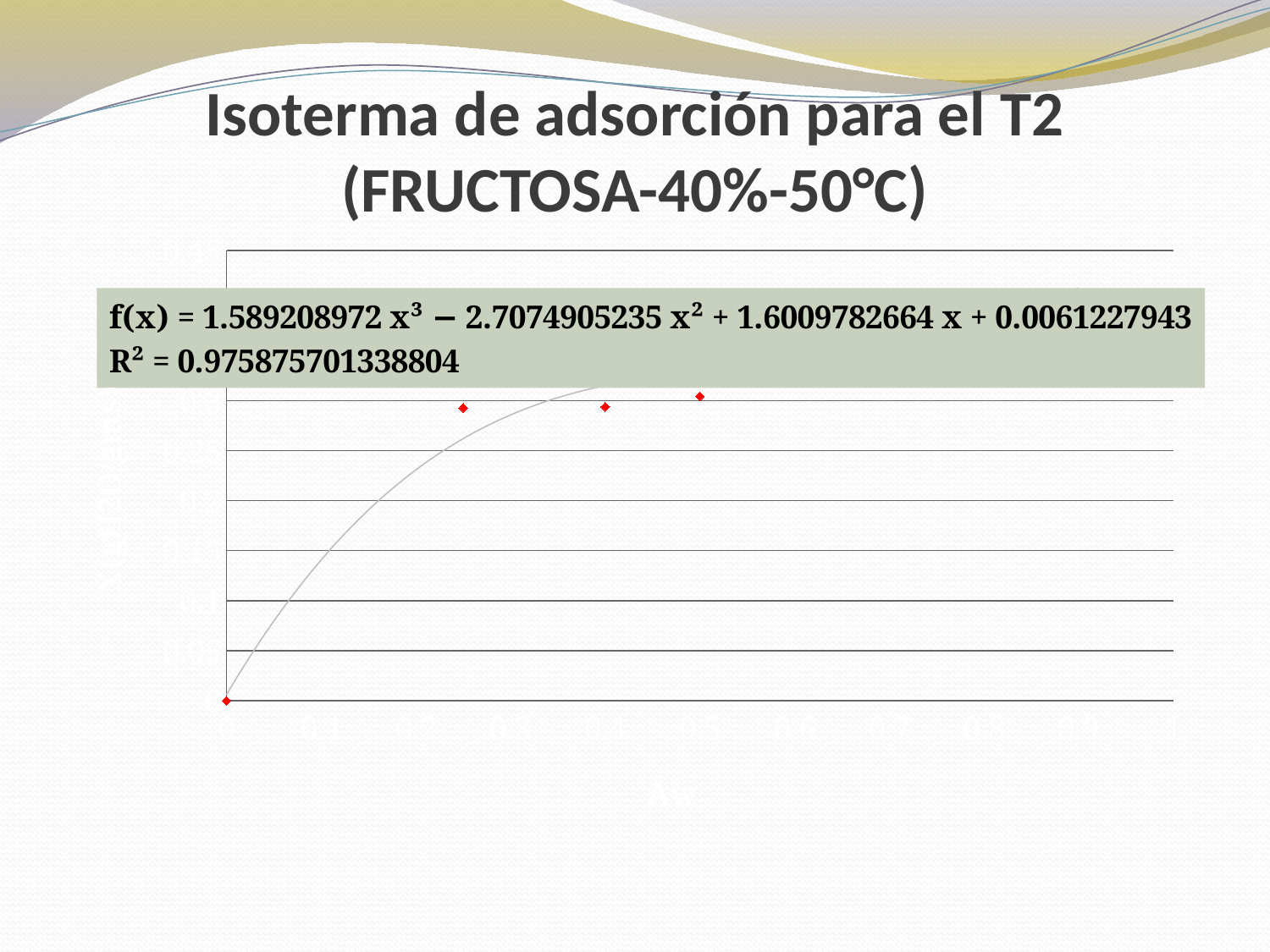
What kind of chart is shown on the slide? scatter chart Which data point has the lowest value, the one at Aw = 0 or the one at Aw = 0.5? Aw = 0 Is the value of the data point at Aw = 0.4 larger than the value at Aw = 0? yes Is the value of the data point at Aw = 0.25 greater or less than 0.1? greater What is the title of the chart on the slide? Isoterma de adsorción para el T2 (FRUCTOSA-40%-50°C) What R² value is printed on the chart? 0.975875701338804 What is the label of the x axis? Aw Is the value of the data point at Aw = 0.5 greater or less than 0.2? greater Do the plotted values rise or fall as Aw increases from 0 to 0.5? rise